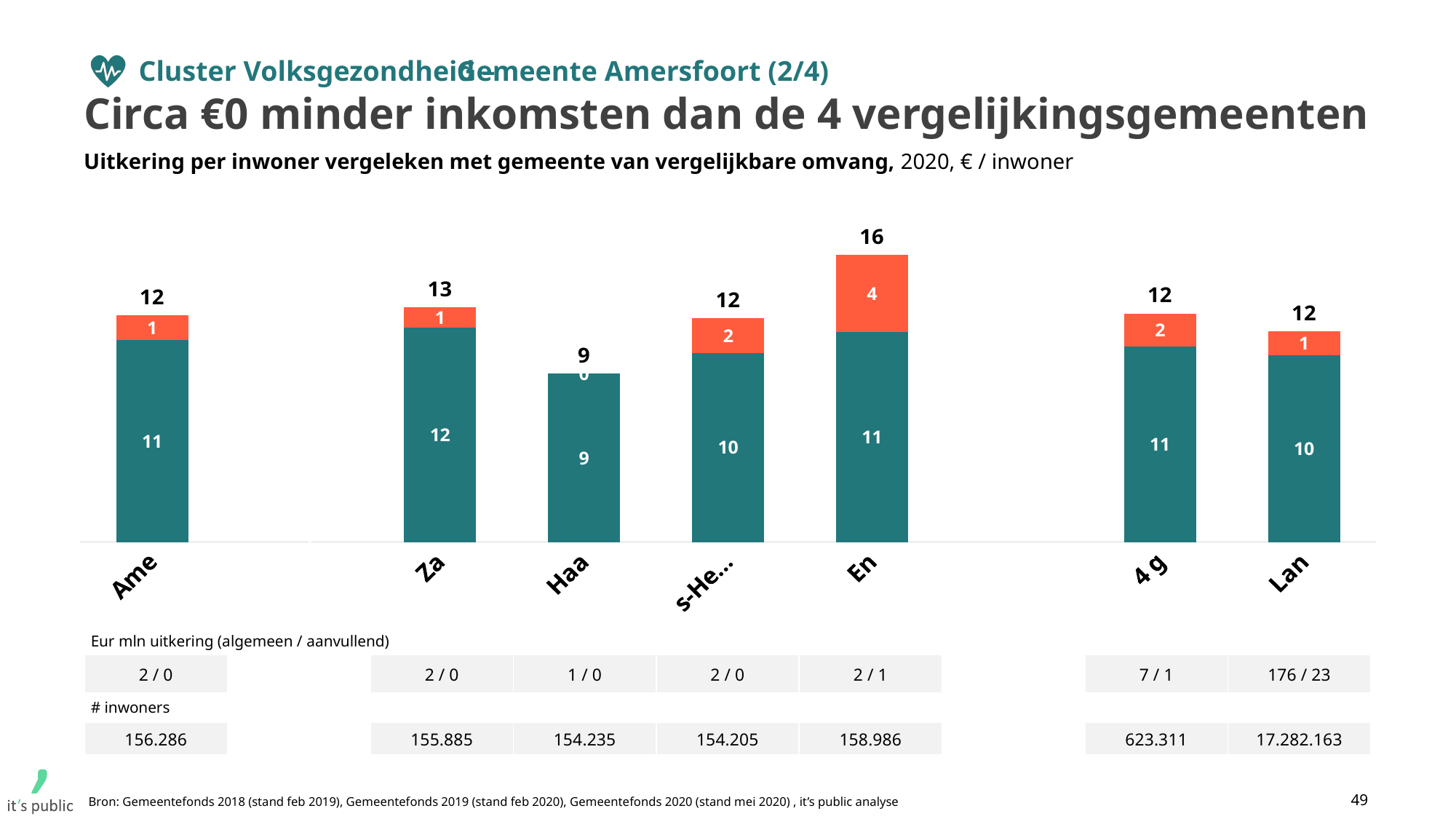
What is the value of the bottom (teal) segment of the bar for Lan? 10 What is the total value shown above the bar for En? 16 What is the value of the bottom (teal) segment of the bar for Ame? 11 What year does the chart subtitle say the data refers to? 2020 What is the difference between the total for En and the total for Haa? 7 Which category has the lowest total value? Haa Which category has the highest total value? En What kind of chart is shown on the slide? Stacked bar chart How many bars are shown in the chart? 7 What is the total of the stacked bar for Lan? 12 What is the value of the top (orange) segment of the bar for En? 4 Which has a larger total value, Za or Ame? Za